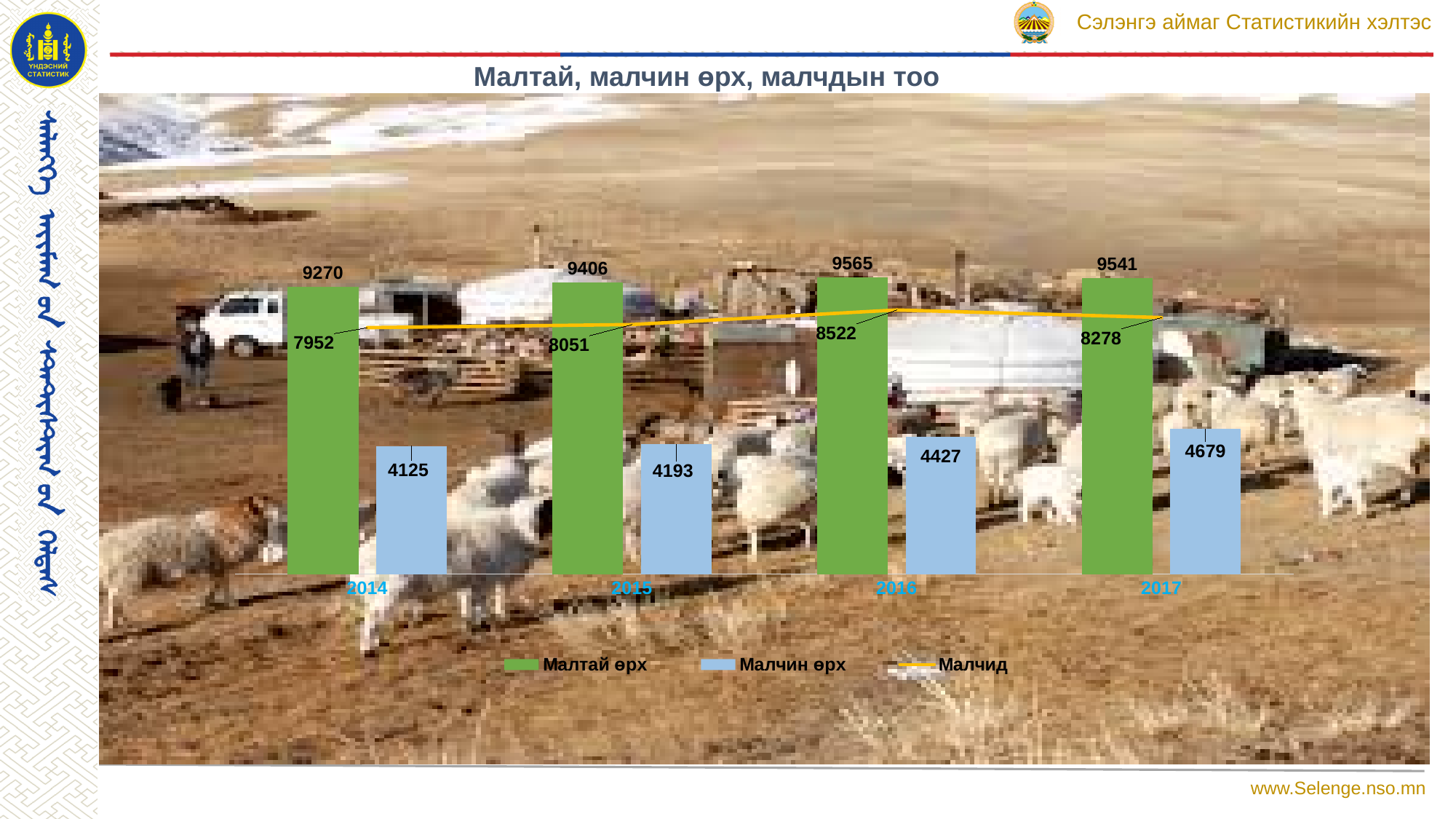
In which year is Малтай өрх highest? 2016 What is the difference between Малтай өрх and Малчин өрх in 2017? 4862 What is the value of Малтай өрх in 2016? 9565 What kind of chart is this? Combined bar and line chart Which is larger, Малчид in 2016 or Малчид in 2017? Малчид in 2016 Does Малчин өрх rise or fall from 2014 to 2017? Rise How many years are shown on the x axis? 4 In which year is Малчин өрх lowest? 2014 What is the value of Малчид in 2017? 8278 How many series does the legend list? 3 What is the title of the chart? Малтай, малчин өрх, малчдын тоо What is the value of Малчин өрх in 2014? 4125